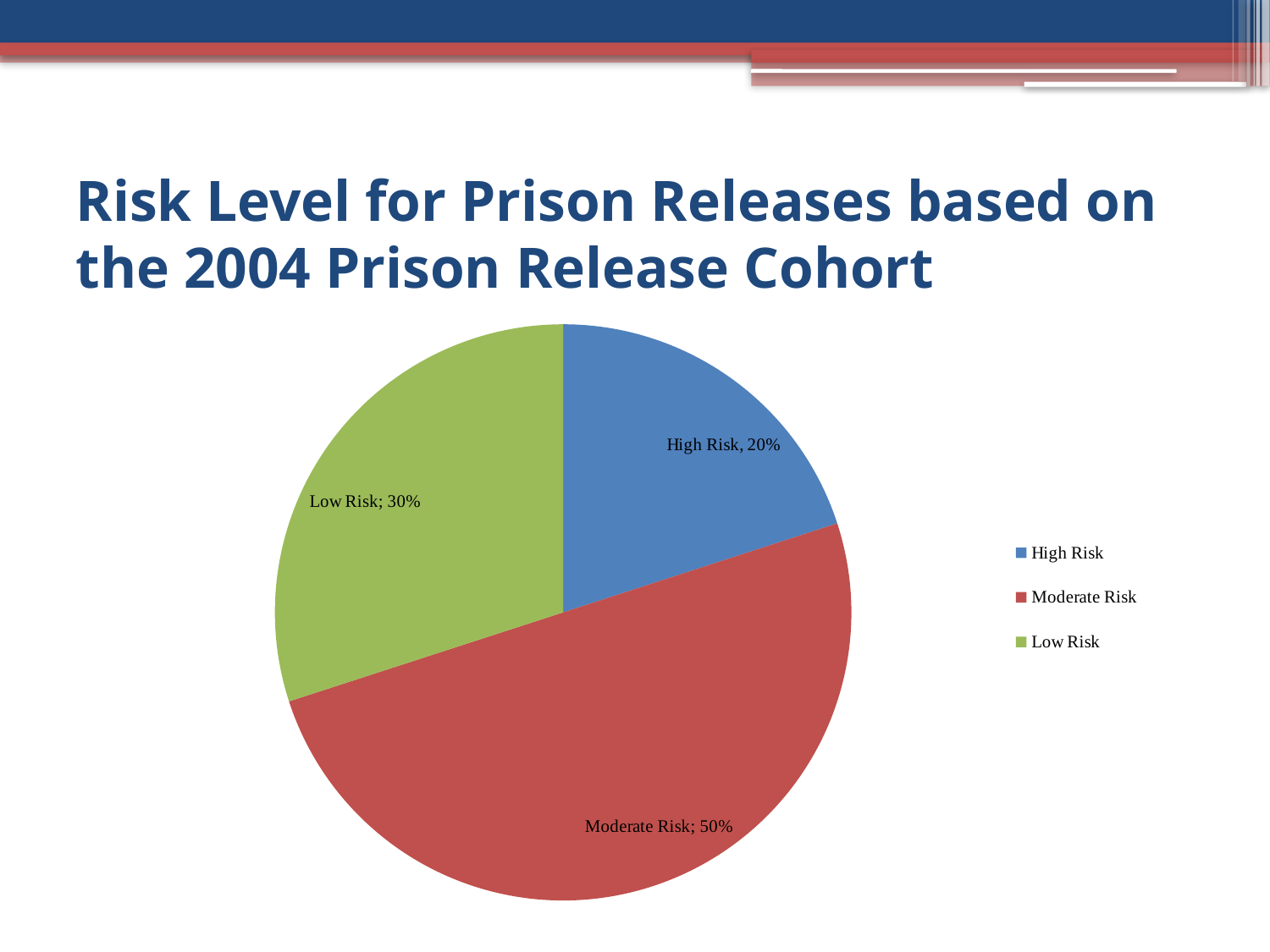
How many slices does the pie chart have? 3 What percentage of prison releases are labelled Moderate Risk? 50% What is the title of the slide containing the pie chart? Risk Level for Prison Releases based on the 2004 Prison Release Cohort What percentage of prison releases are labelled High Risk? 20% How many entries does the legend list? 3 Which slice is larger, Low Risk or High Risk? Low Risk What is the difference in percentage points between the Moderate Risk and High Risk slices? 30 What colour is the Moderate Risk slice? red Which risk level has the smallest share of the pie? High Risk Which risk level has the largest share of the pie? Moderate Risk What percentage of prison releases are labelled Low Risk? 30% What kind of chart is shown on the slide? pie chart